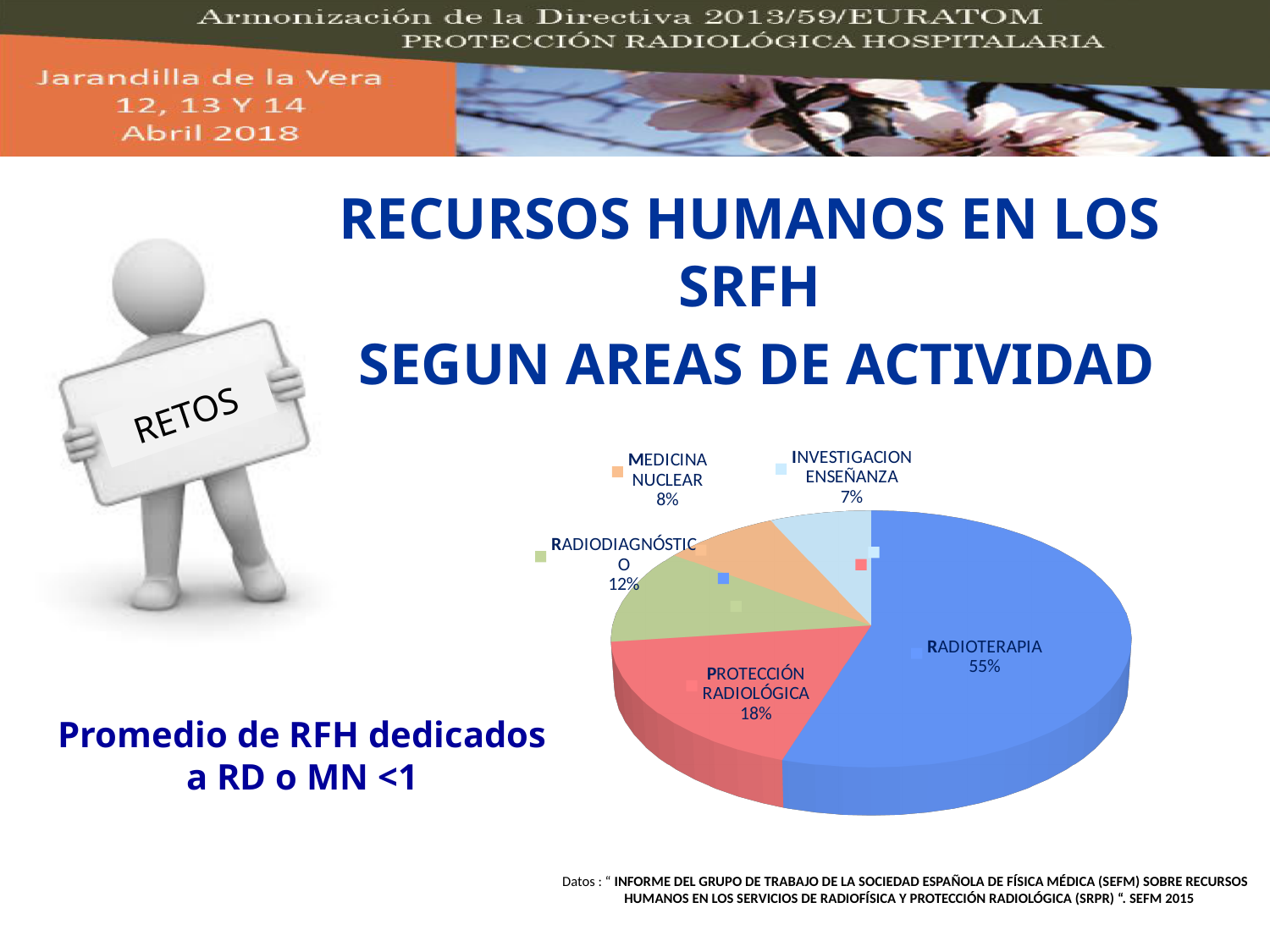
What colour is the RADIOTERAPIA slice of the pie? Blue Which category has the smallest slice of the pie? INVESTIGACION ENSEÑANZA What kind of chart is shown on the slide? Pie chart Which is larger, the share for RADIODIAGNÓSTICO or the share for MEDICINA NUCLEAR? RADIODIAGNÓSTICO What is the difference in percentage points between RADIOTERAPIA and PROTECCIÓN RADIOLÓGICA? 37 Which category has the largest slice of the pie? RADIOTERAPIA How many slices does the pie chart have? 5 What share of the pie does MEDICINA NUCLEAR have? 8% What share of the pie does PROTECCIÓN RADIOLÓGICA have? 18% What share of the pie does RADIOTERAPIA have? 55%